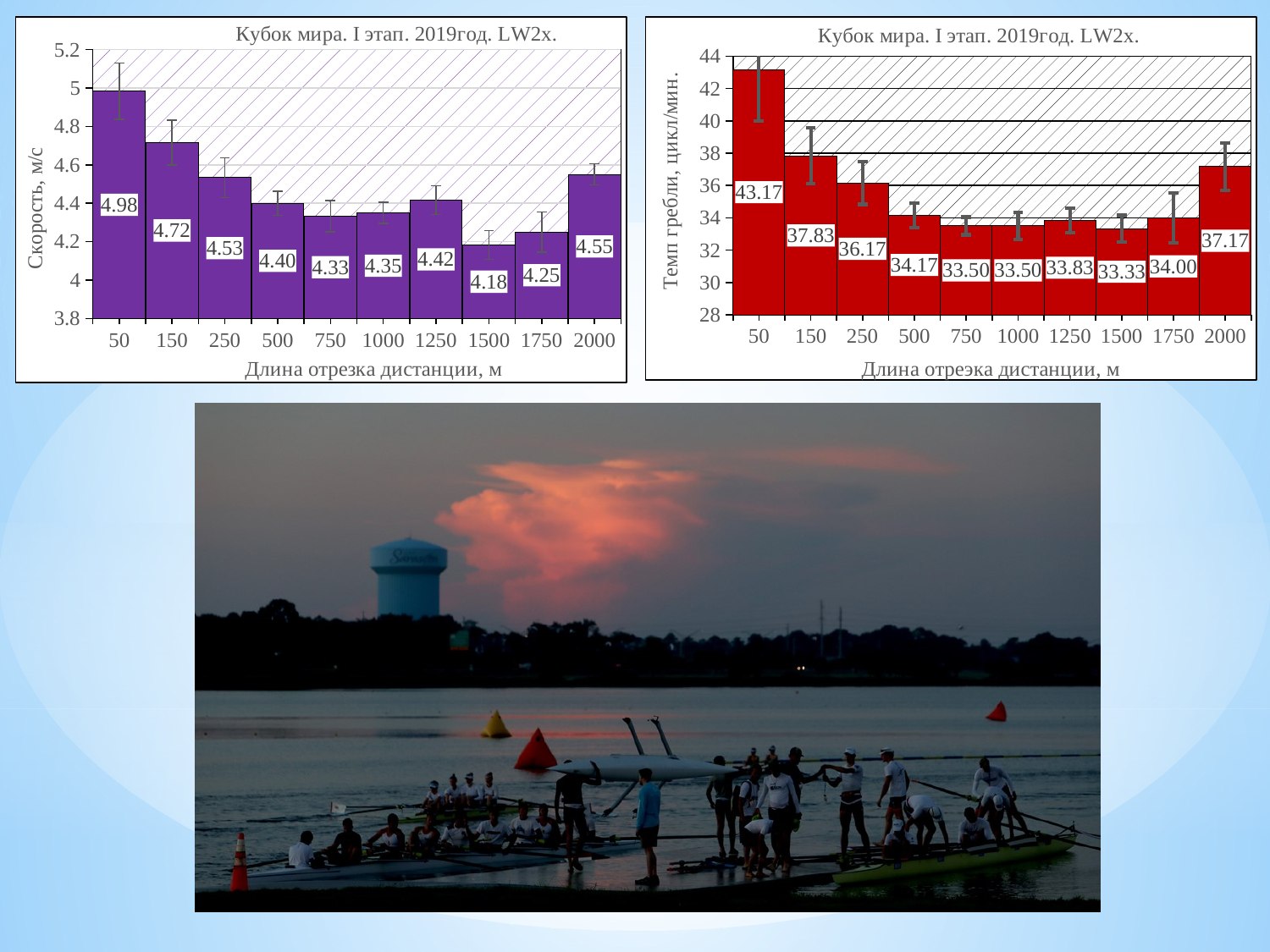
How many distance segments are shown on the x axis of the left chart (Скорость, м/с)? 10 In the right chart (Темп гребли, цикл/мин.), which segment has the highest stroke rate? 50 In the left chart (Скорость, м/с), what is the difference between the values for 50 m and 2000 m? 0.43 In the left chart (Скорость, м/с), which is larger: the value for 1250 m or the value for 1750 m? 1250 m In the left chart (Скорость, м/с), what is the value for the 50 m segment? 4.98 What is the y-axis label of the left chart? Скорость, м/с In the left chart (Скорость, м/с), which segment has the lowest speed? 1500 What kind of chart is the right chart (Темп гребли, цикл/мин.)? bar chart In the right chart (Темп гребли, цикл/мин.), what is the value for the 2000 m segment? 37.17 In the right chart (Темп гребли, цикл/мин.), what is the difference between the values for 50 m and 150 m? 5.34 In the right chart (Темп гребли, цикл/мин.), which segment has the lowest stroke rate? 1500 In the right chart (Темп гребли, цикл/мин.), is the value for 250 m greater or less than 36? greater